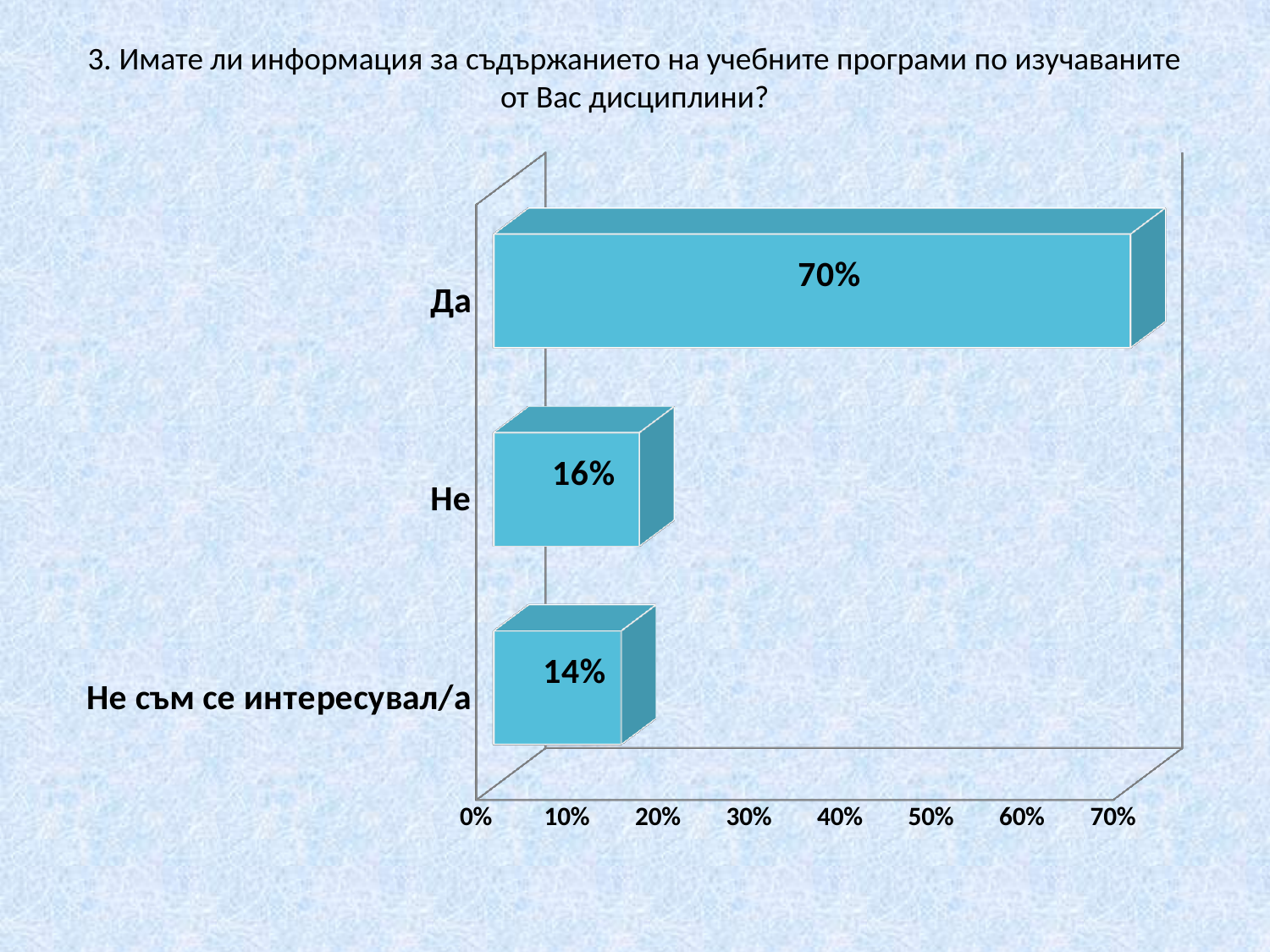
What is the highest value shown on the horizontal axis? 70% What is the difference between the values for "Не" and "Не съм се интересувал/а"? 2% Which category has the lowest value? Не съм се интересувал/а Is the value for "Да" greater or less than 50%? greater What is the value for "Да"? 70% What is the value for "Не съм се интересувал/а"? 14% What is the difference between the values for "Да" and "Не"? 54% What is the value for "Не"? 16% What kind of chart is shown on the slide? bar chart How many categories are shown in the chart? 3 Which category has the highest value? Да Which is larger, the value for "Да" or the value for "Не"? Да